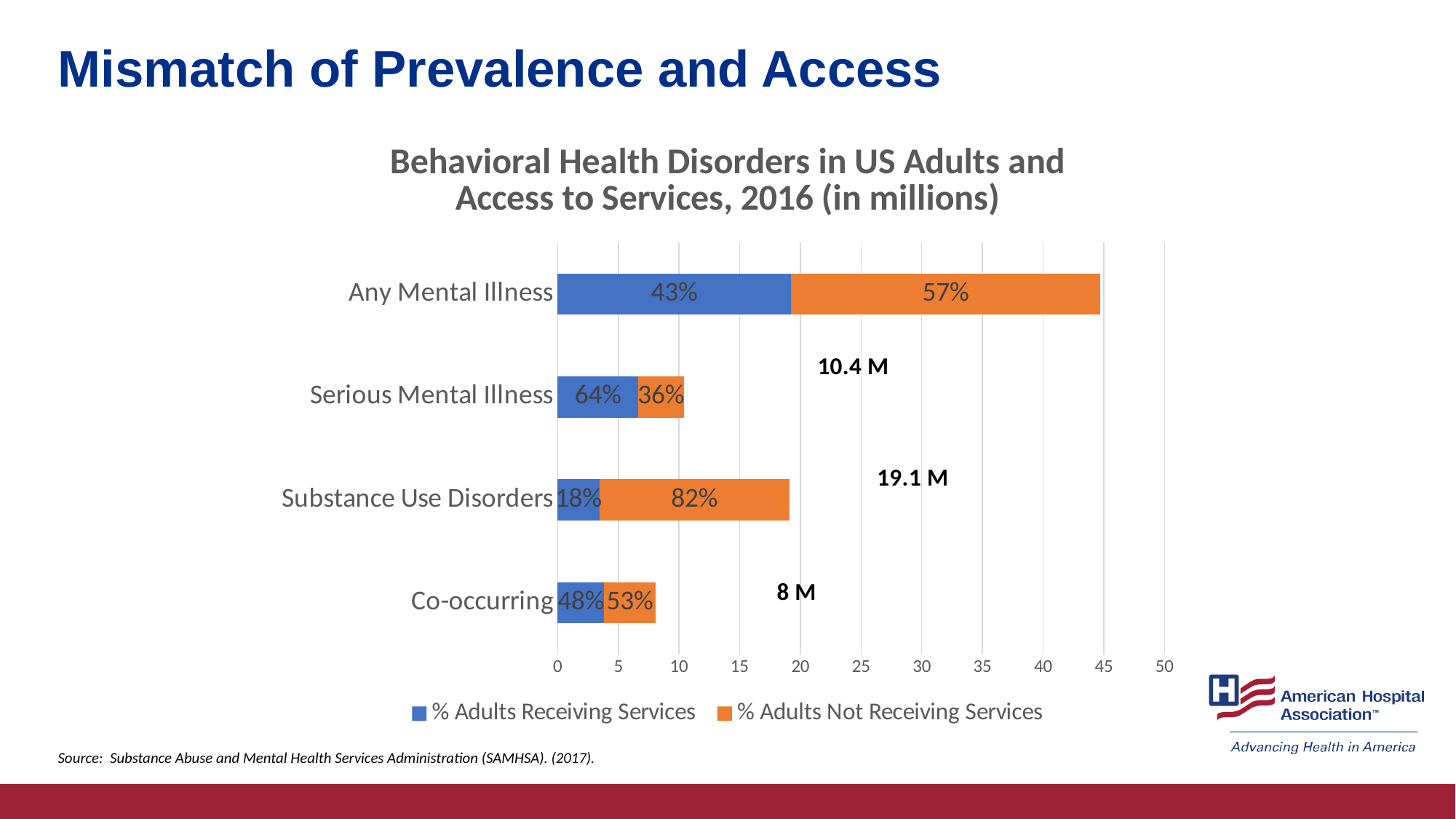
How many categories are shown on the vertical axis? 4 Which category has the shortest total bar? Co-occurring What is the % Adults Receiving Services value for Serious Mental Illness? 64% For Serious Mental Illness, which is larger: the share receiving services or the share not receiving services? Receiving services What is the title of the chart? Behavioral Health Disorders in US Adults and Access to Services, 2016 (in millions) How many series does the legend list? 2 What percentage of adults with Substance Use Disorders are shown as not receiving services? 82% What is the % Adults Not Receiving Services value for Co-occurring? 53% What kind of chart is shown on the slide? Stacked bar chart Is the total bar length for Any Mental Illness greater or less than 40? greater Which category has the longest total bar? Any Mental Illness What percentage of adults with Any Mental Illness are shown as receiving services? 43%